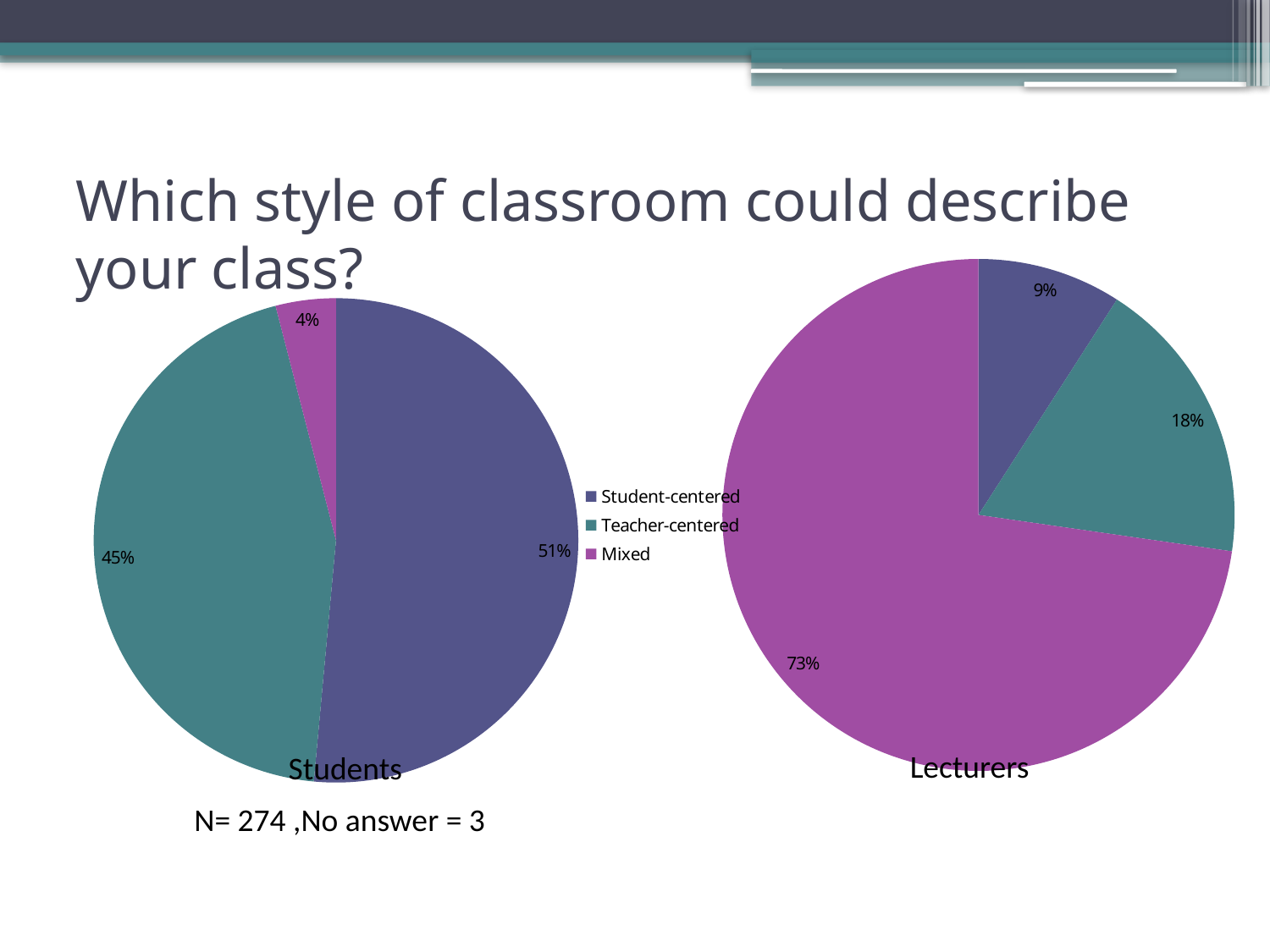
In the Students pie chart, what is the difference between the Student-centered and Teacher-centered shares? 6% In the Lecturers pie chart, what share is Mixed? 73% In the Lecturers pie chart, what share is Student-centered? 9% In the Students pie chart, what share is Student-centered? 51% In the Students pie chart, what share is Teacher-centered? 45% How many categories does the legend list? 3 What type of chart is used on this slide? Pie chart Which is larger: the Mixed share in the Lecturers chart or the Mixed share in the Students chart? Lecturers In the Lecturers pie chart, which category has the largest slice? Mixed In the Students pie chart, what share is Mixed? 4% In the Lecturers pie chart, what share is Teacher-centered? 18% In the Students pie chart, which category has the smallest slice? Mixed